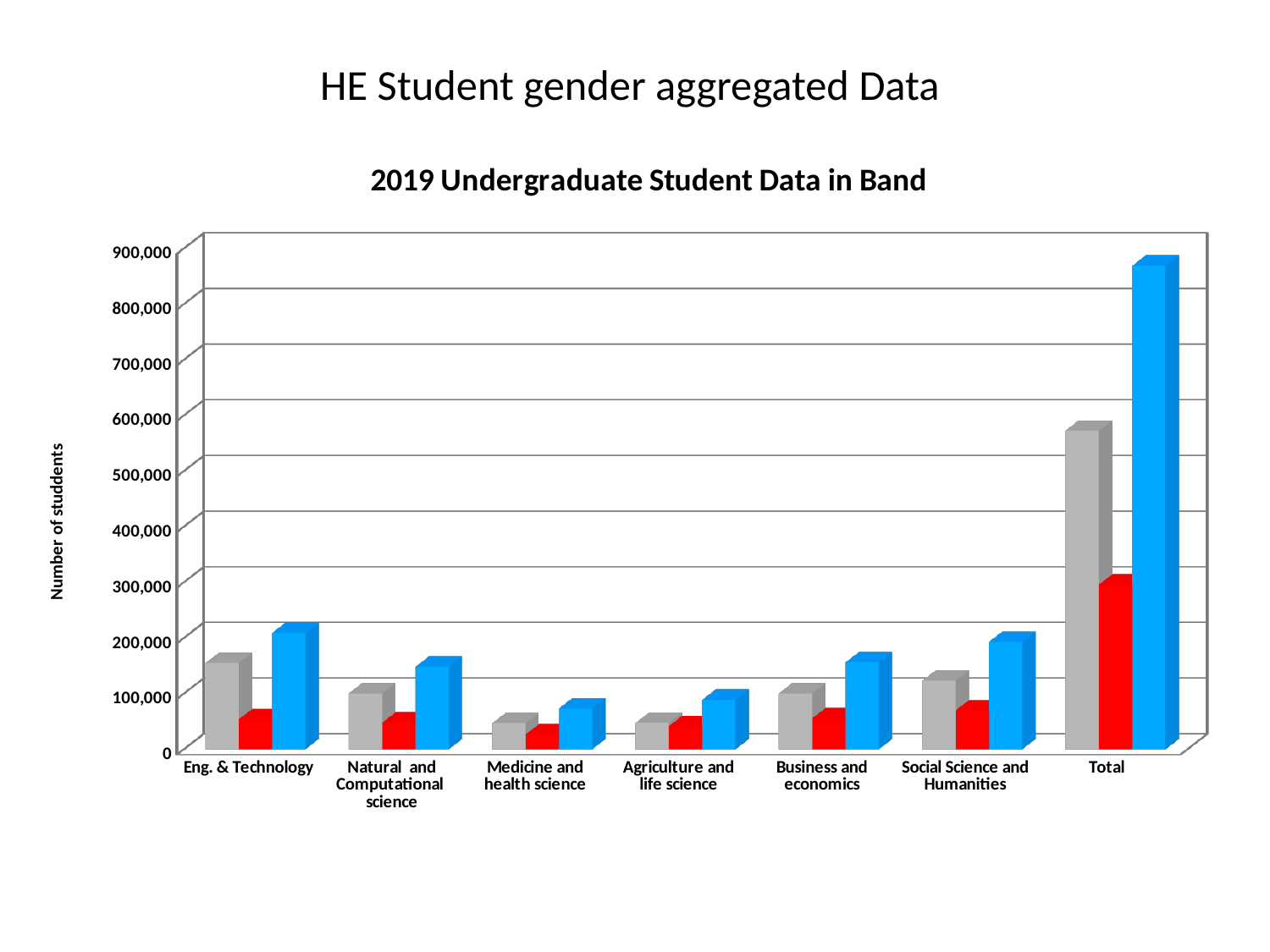
Which category has the tallest blue bar? Total How many categories are shown along the x axis of the chart? 7 Is the blue bar for Total greater or less than 800,000? greater Excluding Total, which category has the tallest blue bar? Eng. & Technology Which is larger, the gray bar for Eng. & Technology or the gray bar for Natural and Computational science? Eng. & Technology Is the gray bar for Total greater or less than 500,000? greater Is the red bar for Medicine and health science greater or less than 100,000? less What is the title of the chart? 2019 Undergraduate Student Data in Band Which category has the shortest red bar? Medicine and health science What kind of chart is shown on the slide? bar chart What is the label on the vertical axis of the chart? Number of studdents